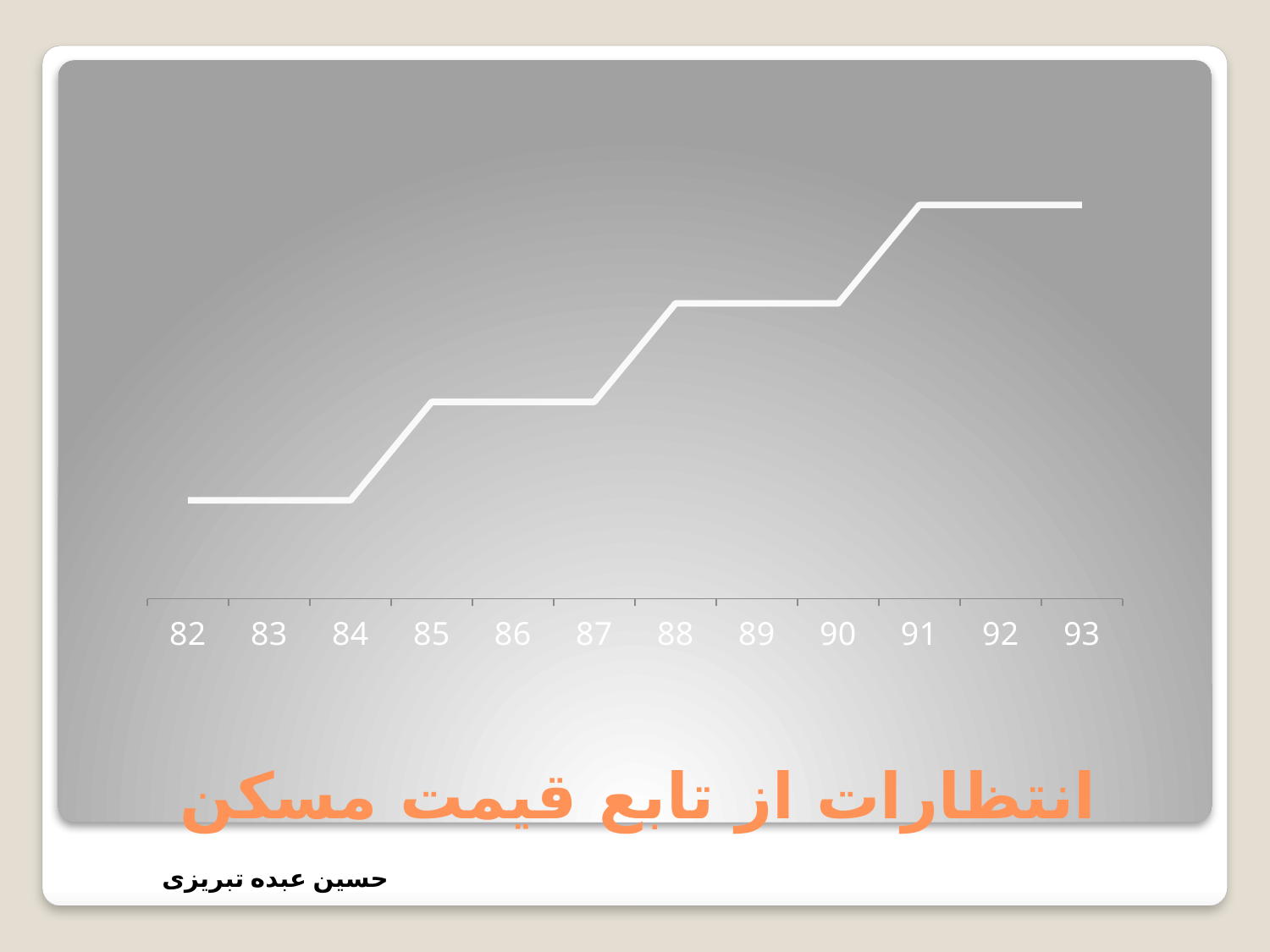
Do the values in the chart generally rise or fall from 82 to 93 along the x axis? rise Which has the higher value in the chart, 90 or 91? 91 Which has the lower value in the chart, 83 or 89? 83 Which has the higher value in the chart, 86 or 88? 88 What is the first category label on the x axis of the chart? 82 What is the last category label on the x axis of the chart? 93 What kind of chart is shown on the slide? line chart How many categories are labelled on the x axis of the chart? 12